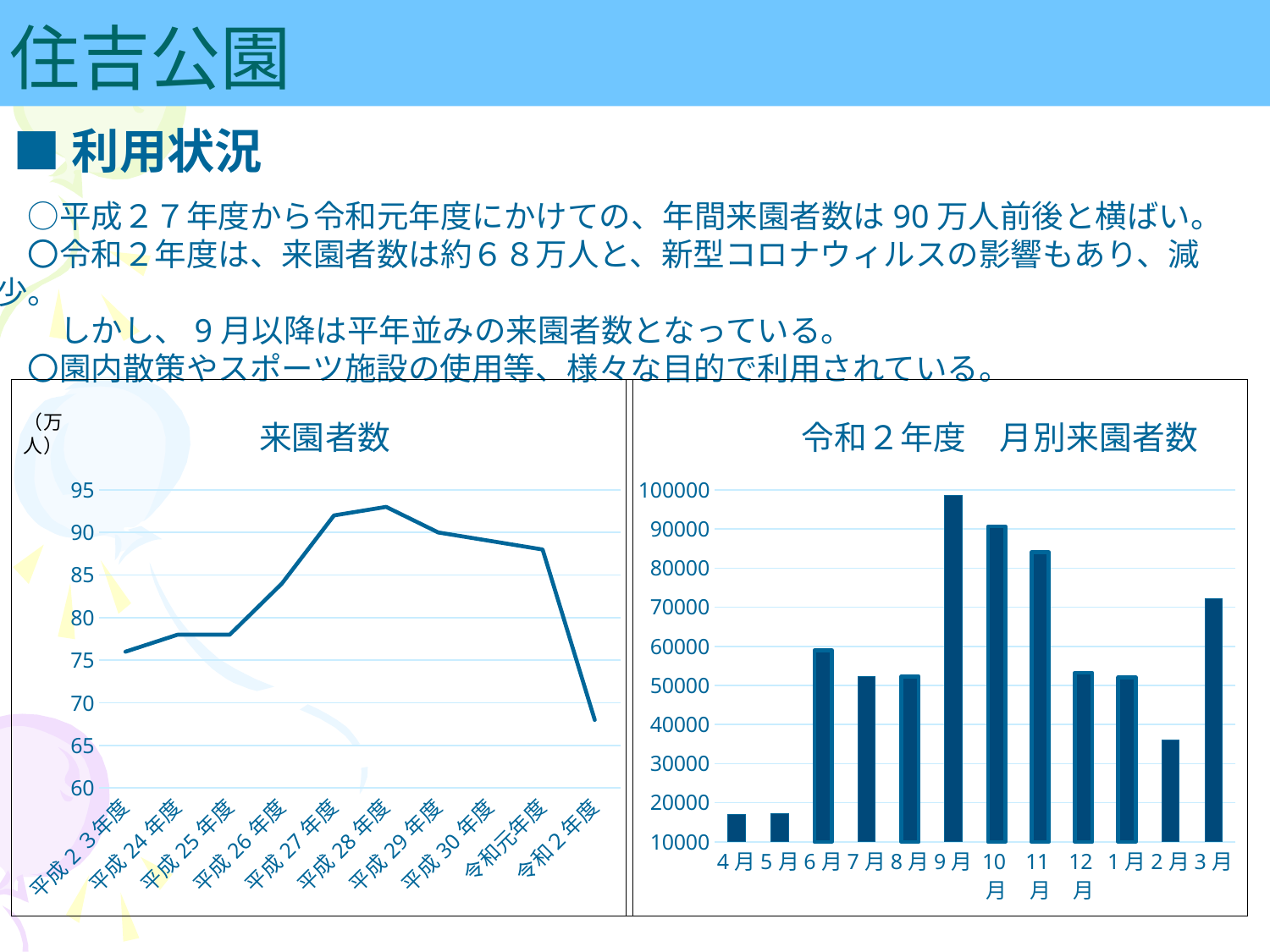
What kind of chart is the chart titled 来園者数 on the left? line chart In the chart titled 令和２年度 月別来園者数, which month has the tallest bar? 9月 In the chart titled 来園者数, how many fiscal years are plotted along the x axis? 10 In the chart titled 来園者数, which fiscal year has the lowest value? 令和２年度 In the chart titled 令和２年度 月別来園者数, how many months are shown on the x axis? 12 In the chart titled 令和２年度 月別来園者数, is the value for 2月 greater or less than 40000? less In the chart titled 令和２年度 月別来園者数, which is larger, the value for 10月 or the value for 3月? 10月 What kind of chart is the chart titled 令和２年度 月別来園者数 on the right? bar chart In the chart titled 令和２年度 月別来園者数, is the value for 9月 greater or less than 90000? greater In the chart titled 来園者数, is the value for 令和２年度 greater or less than 70? less In the chart titled 来園者数, which fiscal year has the highest value? 平成28年度 In the chart titled 来園者数, does the line rise or fall between 令和元年度 and 令和２年度? fall